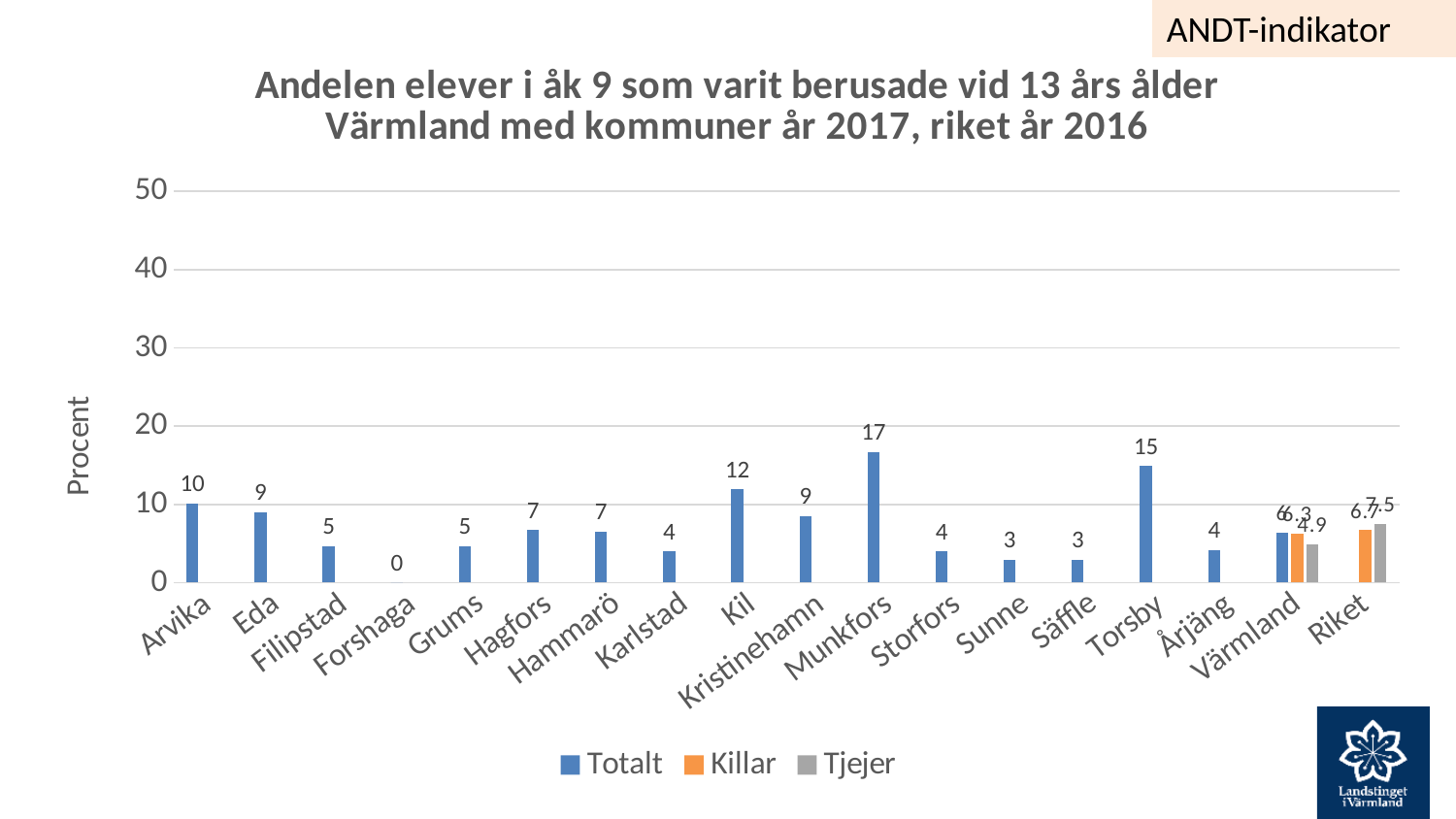
What is the Killar value for Riket? 6.7 Which category has the lowest Totalt value? Forshaga What is the Totalt value for Forshaga? 0 How many categories are shown on the x axis? 18 What is the Totalt value for Kil? 12 Which municipality has the highest Totalt value? Munkfors What is the Tjejer value for Riket? 7.5 What kind of chart is shown on the slide? Bar chart What is the difference between the Totalt values for Munkfors and Torsby? 2 Which has a higher Totalt value, Arvika or Eda? Arvika How many series does the legend list? 3 What is the Totalt value for Munkfors? 17